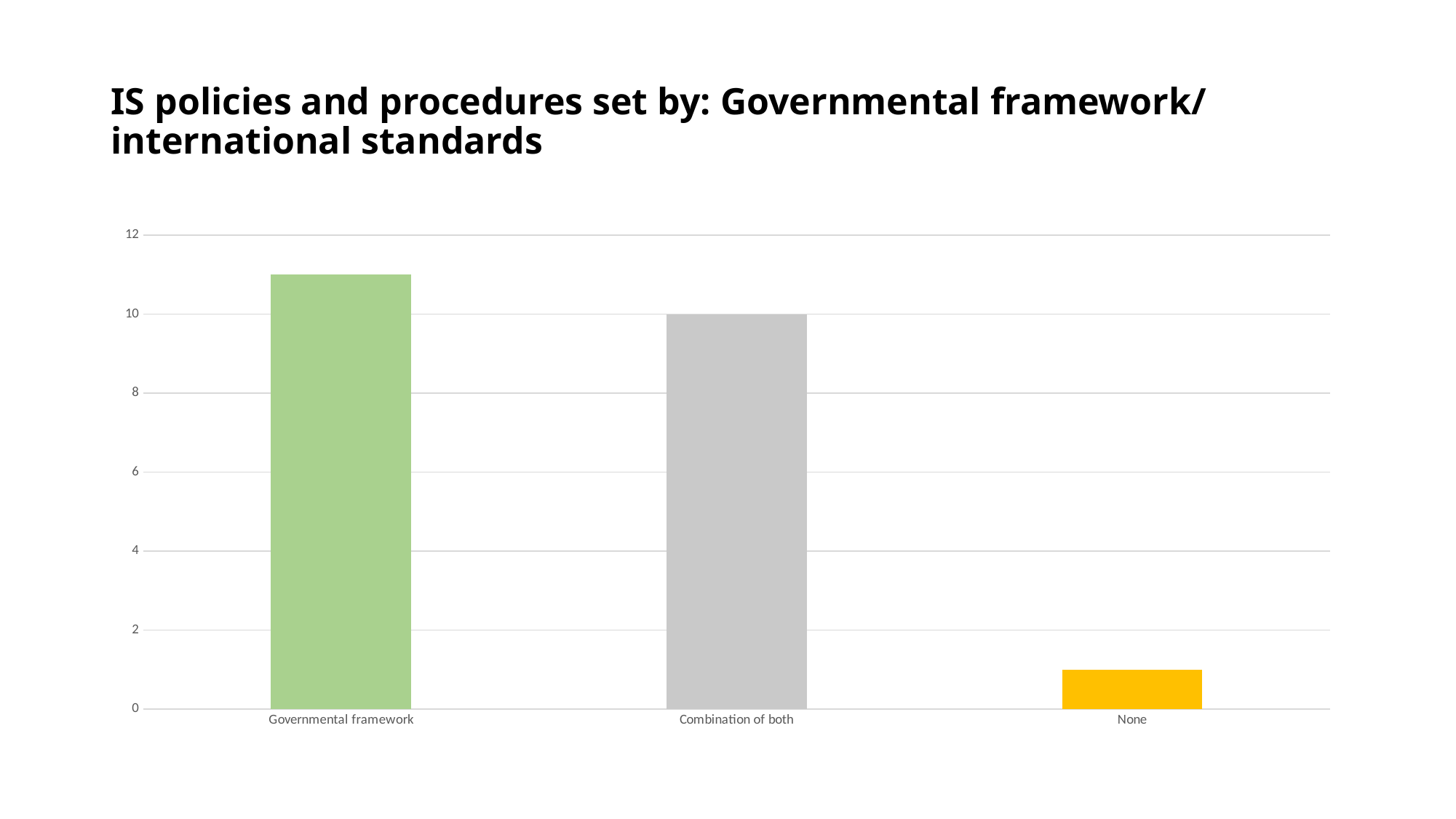
What colour is the bar for None? Yellow Do the values rise or fall moving from left to right along the x axis? Fall Is the value for Governmental framework greater or less than 10? greater Is the value for Governmental framework greater or less than 12? less Which is larger, the value for None or the value for Combination of both? Combination of both Which is larger, the value for Governmental framework or the value for Combination of both? Governmental framework Which category has the lowest value? None How many categories are shown on the x axis of the chart? 3 Which category has the highest value? Governmental framework What type of chart is shown on the slide? Bar chart What is the value for Combination of both? 10 Is the value for None greater or less than 2? less